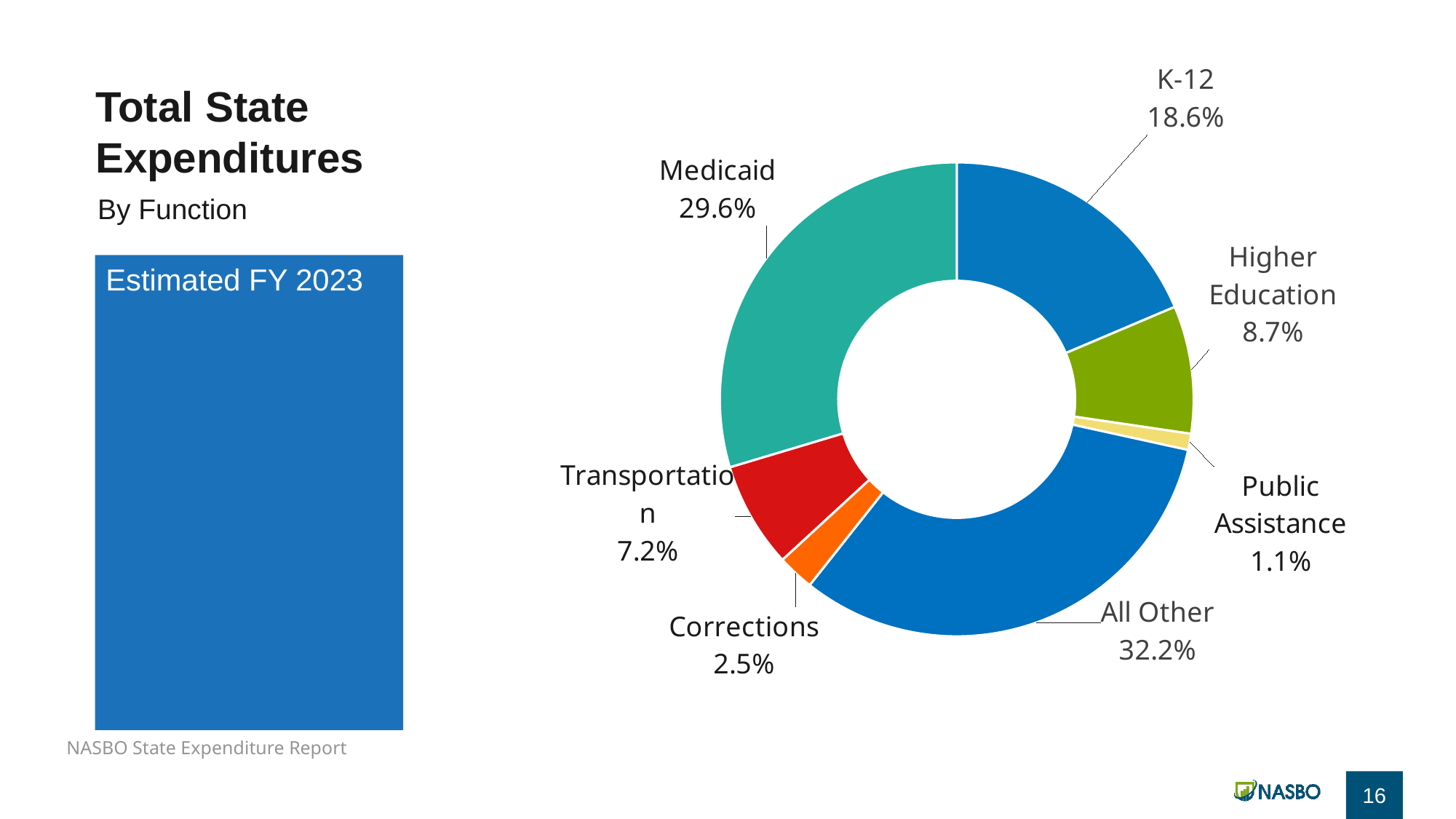
What share of total state expenditures goes to Public Assistance? 1.1% What share of total state expenditures goes to K-12? 18.6% What share of total state expenditures goes to Higher Education? 8.7% What share of total state expenditures goes to Medicaid? 29.6% What share of total state expenditures goes to Corrections? 2.5% Which fiscal year does the chart cover? Estimated FY 2023 Which has a larger share, Transportation or Corrections? Transportation What kind of chart is shown on the slide? Doughnut (pie) chart How many functions are shown in the chart? 7 What is the difference in percentage points between the Medicaid share and the K-12 share? 11.0 percentage points Which function has the smallest share of total state expenditures? Public Assistance Which function has the largest share of total state expenditures? All Other